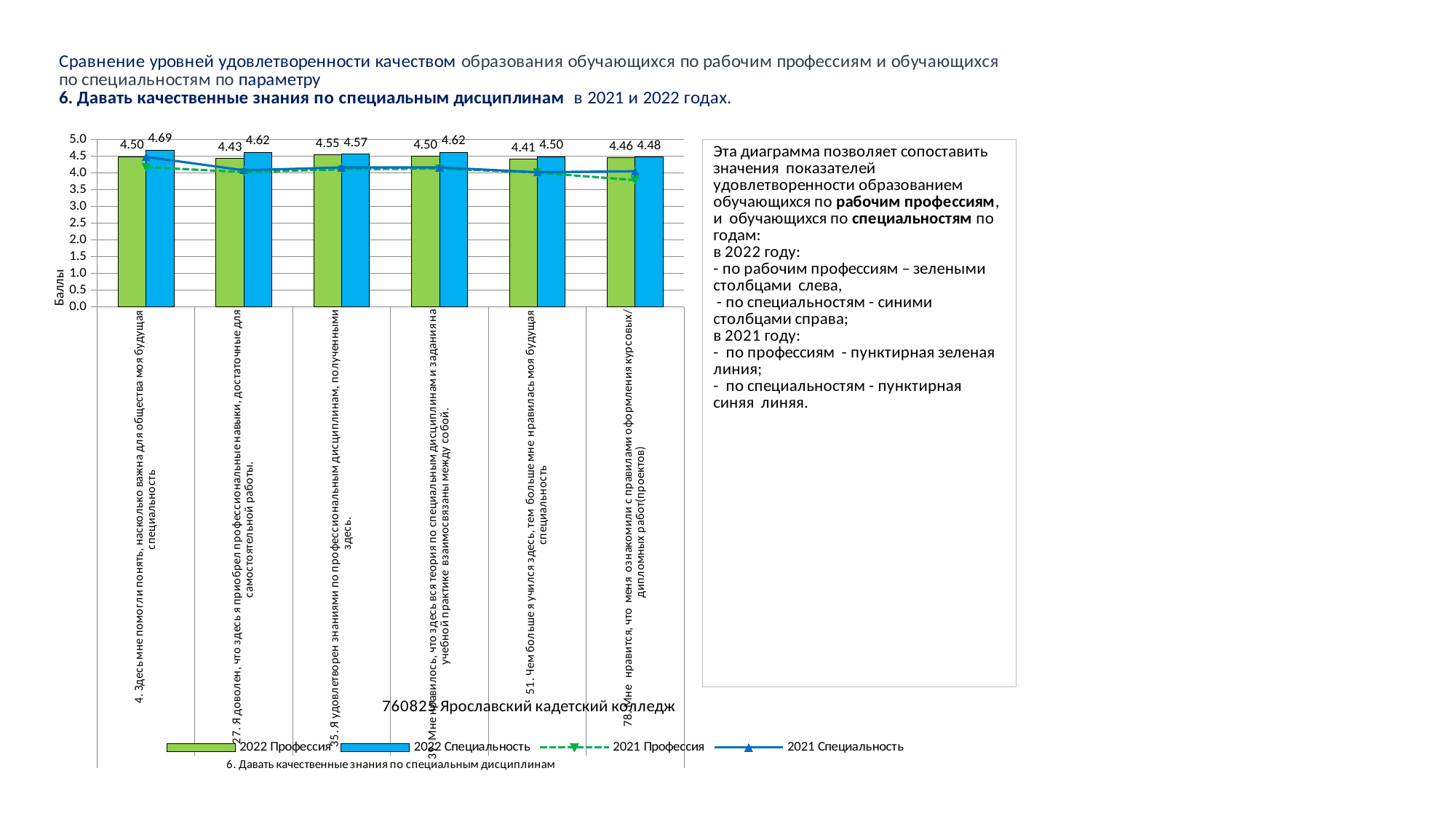
What is the value of the 2022 Специальность bar for category 4 (Здесь мне помогли понять, насколько важна для общества моя будущая специальность)? 4.69 What is the value of the 2022 Профессия bar for category 27 (Я доволен, что здесь я приобрел профессиональные навыки, достаточные для самостоятельной работы)? 4.43 What is the difference between the 2022 Специальность and 2022 Профессия bars for category 4? 0.19 What kind of chart is shown on the slide? Combined bar and line chart How many categories are shown on the x axis of the chart? 6 What is the value of the 2022 Специальность bar for category 78 (Мне нравится, что меня ознакомили с правилами оформления курсовых/дипломных работ)? 4.48 What is the value of the 2022 Профессия bar for category 51 (Чем больше я учился здесь, тем больше мне нравилась моя будущая специальность)? 4.41 Which category has the highest 2022 Специальность bar? 4. Здесь мне помогли понять, насколько важна для общества моя будущая специальность How many series does the chart legend list? 4 What is the label of the vertical axis of the chart? Баллы For category 35 (Я удовлетворен знаниями по профессиональным дисциплинам, полученными здесь), which is larger: the 2022 Профессия bar or the 2022 Специальность bar? 2022 Специальность Which category has the lowest 2022 Профессия bar? 51. Чем больше я учился здесь, тем больше мне нравилась моя будущая специальность